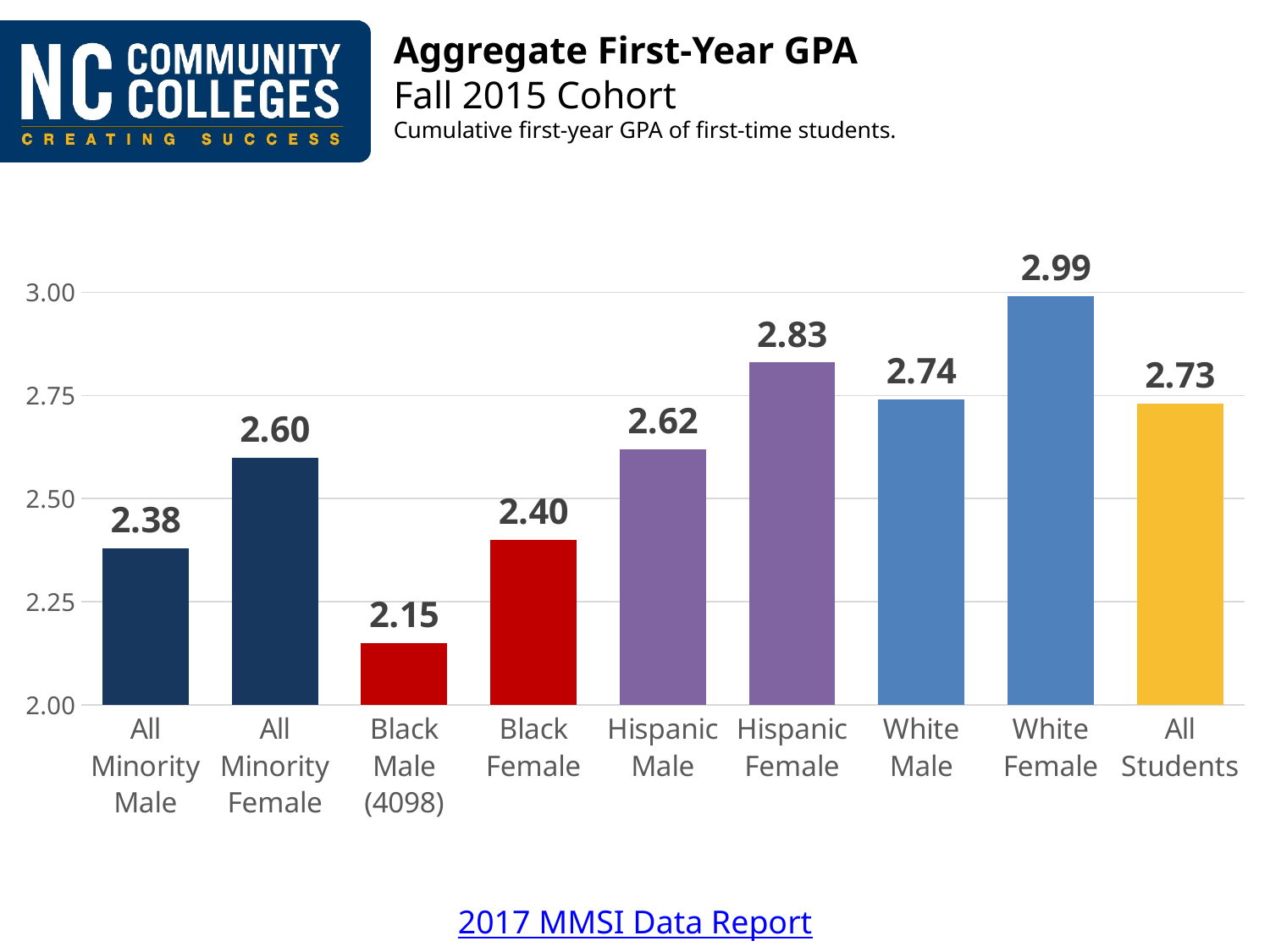
What is the difference between the GPA for White Female and the GPA for Black Male (4098)? 0.84 What is the difference between the GPA for All Minority Female and the GPA for All Minority Male? 0.22 How many categories are shown on the chart? 9 What is the aggregate first-year GPA for Hispanic Male? 2.62 What is the aggregate first-year GPA for All Students? 2.73 Which category has the highest aggregate first-year GPA? White Female What kind of chart is shown on the slide? Bar chart What is the title of the chart? Aggregate First-Year GPA Which is larger, the GPA for Hispanic Female or the GPA for White Male? Hispanic Female What is the aggregate first-year GPA for Black Male (4098)? 2.15 Which category has the lowest aggregate first-year GPA? Black Male (4098) What is the aggregate first-year GPA for White Female? 2.99